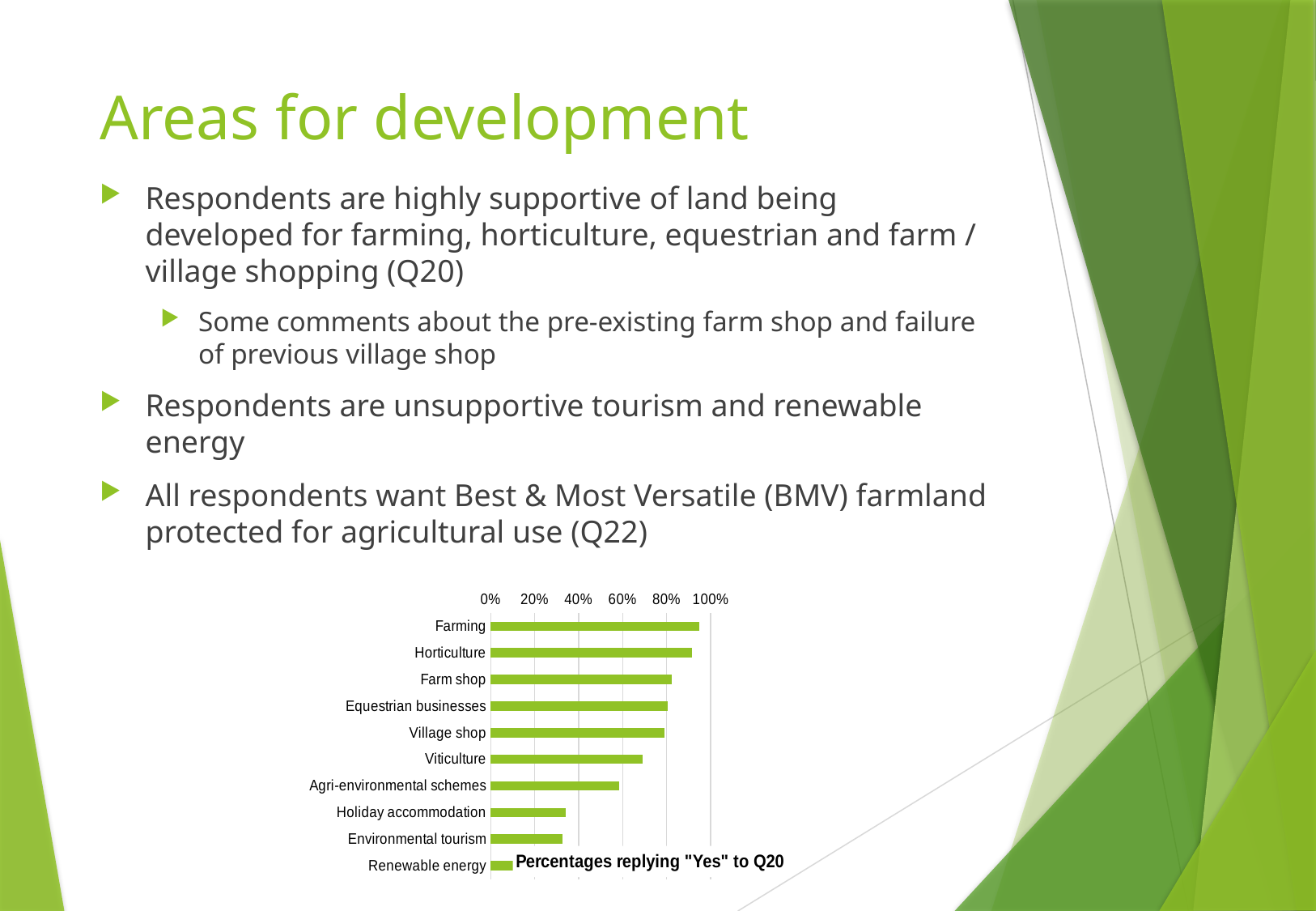
Is the value for Agri-environmental schemes greater or less than 40%? greater Is the value for Viticulture greater or less than 80%? less Which category has the highest percentage replying "Yes" to Q20? Farming What is the title of the chart? Percentages replying "Yes" to Q20 Which category has the lowest percentage replying "Yes" to Q20? Renewable energy Is the value for Farming greater or less than 80%? greater What kind of chart is shown on the slide? Bar chart How many categories are plotted in the chart? 10 Which is larger, the value for Viticulture or the value for Holiday accommodation? Viticulture Which is larger, the value for Horticulture or the value for Farm shop? Horticulture